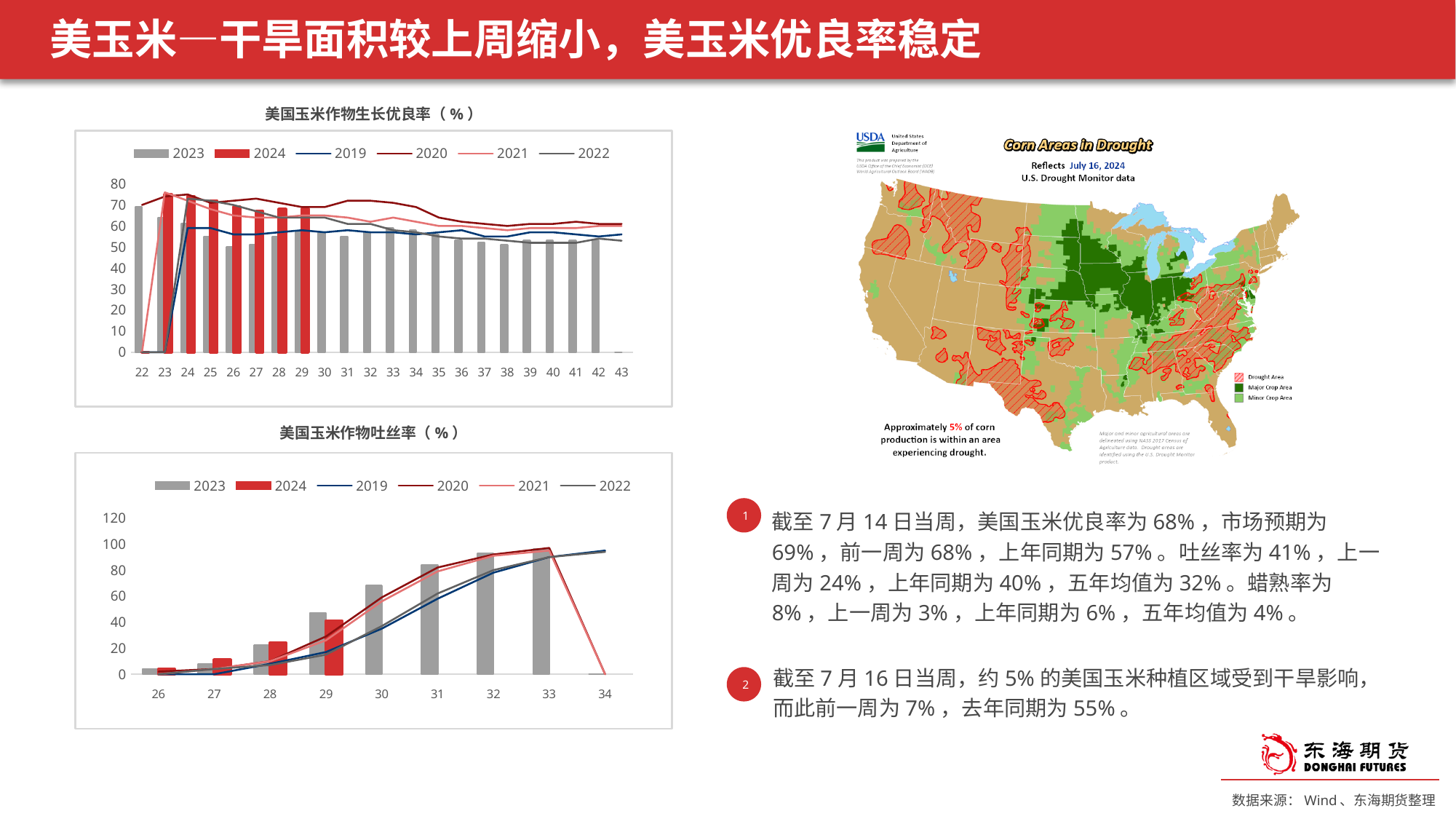
In the chart titled 美国玉米作物生长优良率（%）, how many series does the legend list? 6 In the chart titled 美国玉米作物吐丝率（%）, which week has the lowest 2023 bar? 26 In the chart titled 美国玉米作物吐丝率（%）, do the 2023 bars rise or fall from week 26 to week 33? rise In the chart titled 美国玉米作物吐丝率（%）, is the 2023 bar for week 32 greater or less than 80? greater What is the title of the top-left chart? 美国玉米作物生长优良率（%） In the chart titled 美国玉米作物生长优良率（%）, how many week categories are shown on the x axis? 22 In the chart titled 美国玉米作物生长优良率（%）, is the 2024 bar for week 29 greater or less than 60? greater In the chart titled 美国玉米作物生长优良率（%）, which two series are drawn as bars rather than lines? 2023 and 2024 In the chart titled 美国玉米作物吐丝率（%）, how many week categories are shown on the x axis? 9 In the chart titled 美国玉米作物生长优良率（%）, is the 2023 bar for week 26 greater or less than 60? less In the chart titled 美国玉米作物生长优良率（%）, at week 23, which bar is taller, 2023 or 2024? 2024